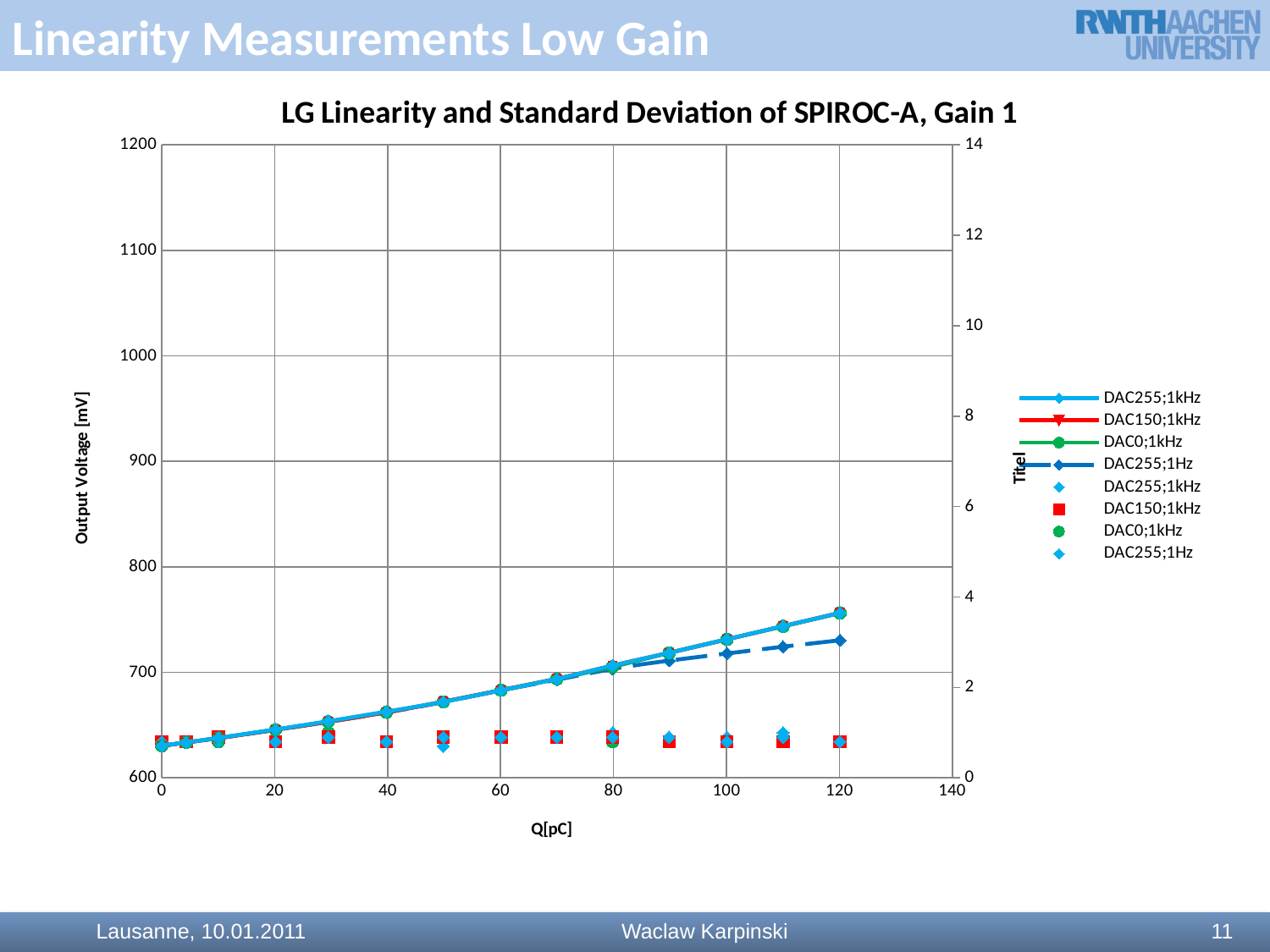
How many series does the legend list? 8 Is the value of the DAC255;1kHz line at Q = 120 pC greater or less than 700 mV? greater What is the title of the chart? LG Linearity and Standard Deviation of SPIROC-A, Gain 1 At Q = 120 pC, which line is higher: DAC255;1kHz or DAC255;1Hz? DAC255;1kHz What is the label of the left vertical axis? Output Voltage [mV] Does the DAC255;1kHz line rise or fall as Q[pC] increases? rise What kind of chart is shown on the slide? line chart Is the value of the DAC255;1Hz line at Q = 120 pC greater or less than 800 mV? less Is the value of the DAC255;1kHz line at Q = 60 pC greater or less than 700 mV? less